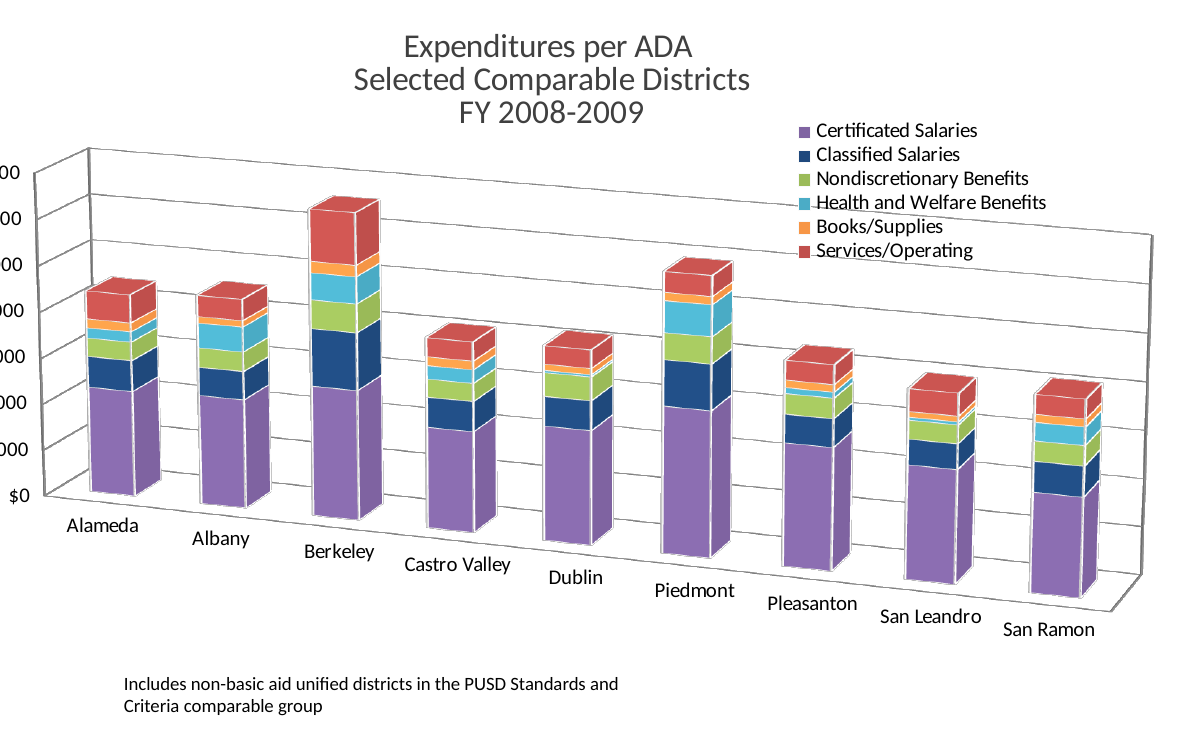
What is the title of the chart? Expenditures per ADA Selected Comparable Districts FY 2008-2009 What kind of chart is shown on the slide? Stacked bar chart Which district is listed last on the x axis? San Ramon Which has higher total expenditures per ADA, Alameda or Castro Valley? Alameda Which district has the second-highest total expenditures per ADA? Piedmont Which has higher total expenditures per ADA, Berkeley or Piedmont? Berkeley Which district has the highest total expenditures per ADA? Berkeley Which series forms the largest segment of every bar in the chart? Certificated Salaries Which has higher total expenditures per ADA, Piedmont or Dublin? Piedmont Which district is listed first on the x axis? Alameda How many series does the legend list? 6 How many districts are shown along the x axis of the chart? 9